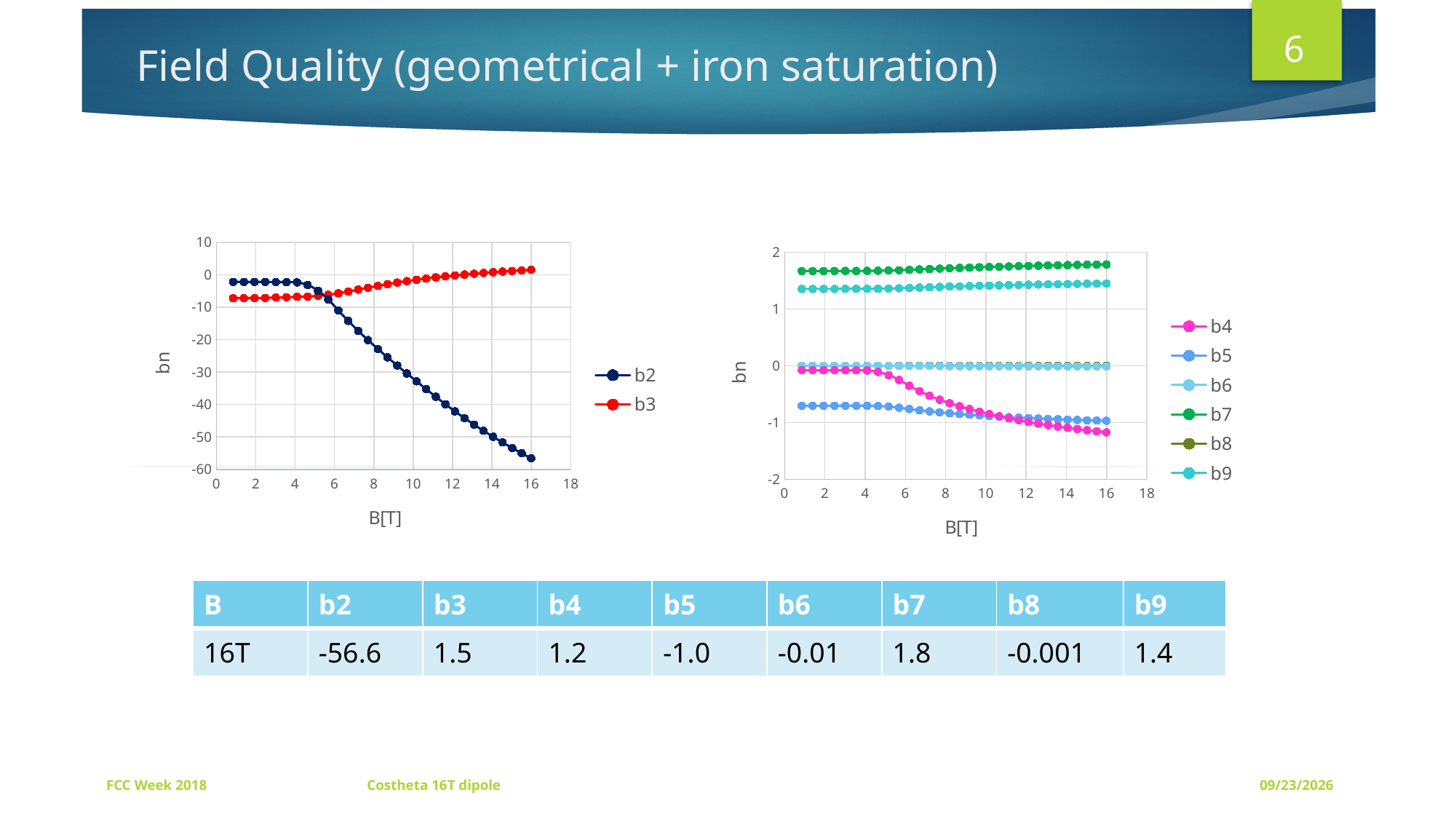
In the right chart, does b4 rise or fall as B[T] increases? fall In the right chart, is the value of b9 at B = 16 T greater or less than 1? greater In the left chart, is the value of b2 at B = 16 T greater or less than -50? less In the right chart, which series has the highest value at B = 16 T? b7 In the left chart, which series has the larger value at B = 16 T, b2 or b3? b3 According to the table, what is the value of b2 at 16T? -56.6 In the left chart, does b2 rise or fall as B[T] increases? fall What is the x-axis label of the right chart? B[T] What kind of chart is the left chart showing b2 and b3? line chart In the left chart, does b3 rise or fall as B[T] increases? rise How many series does the legend of the right chart list? 6 How many series does the legend of the left chart list? 2